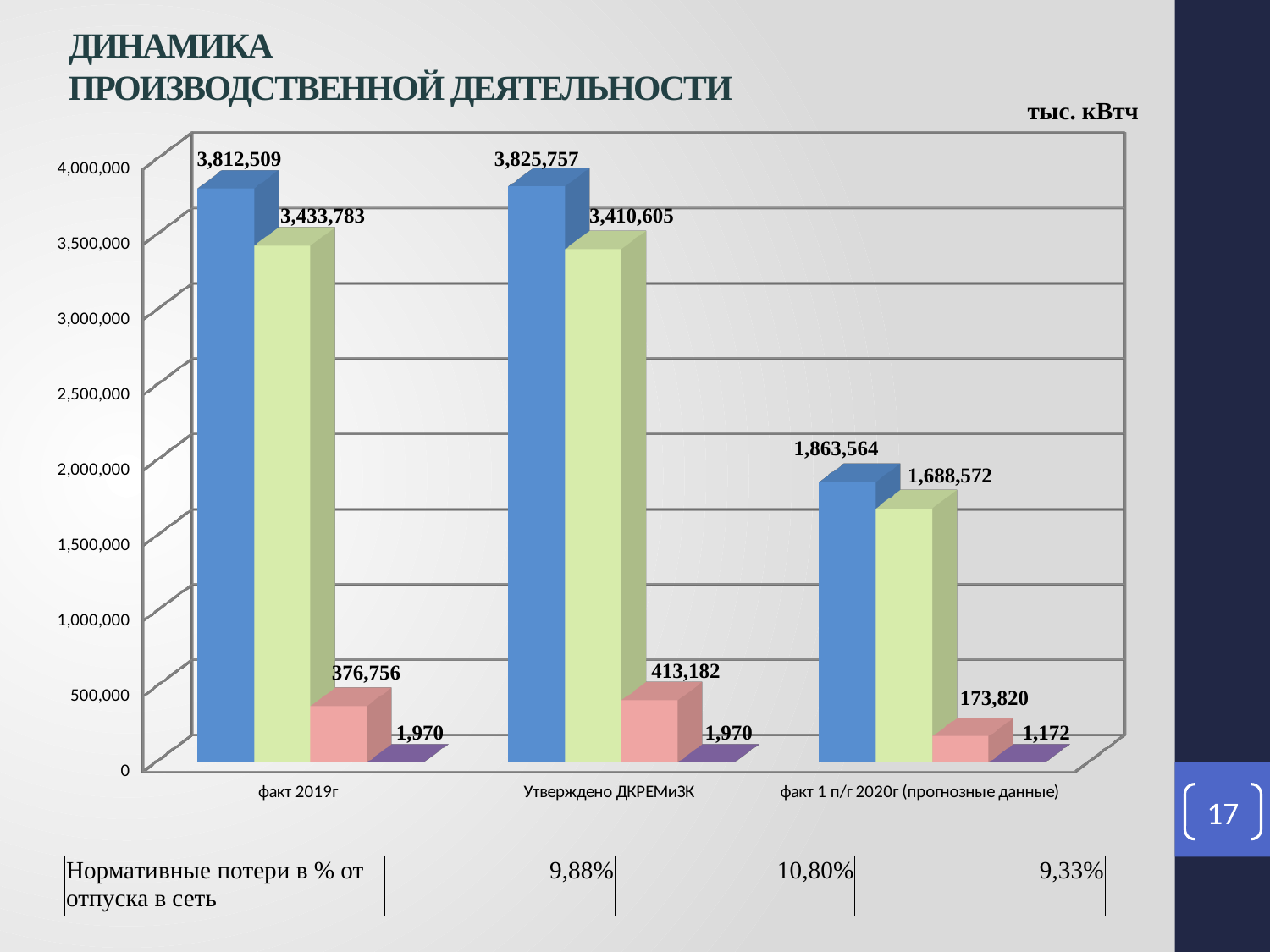
What unit is indicated above the chart? тыс. кВтч What is the value of the green bar for Утверждено ДКРЕМиЗК? 3,410,605 What is the value of the pink bar for факт 1 п/г 2020г (прогнозные данные)? 173,820 What type of chart is shown on the slide? bar chart What is the value of the purple bar for Утверждено ДКРЕМиЗК? 1,970 Which category has the highest blue bar? Утверждено ДКРЕМиЗК Which category has the lowest green bar? факт 1 п/г 2020г (прогнозные данные) Is the blue bar for факт 1 п/г 2020г (прогнозные данные) greater or less than 2,000,000? less What is the value of the blue bar for факт 2019г? 3,812,509 Which is larger: the pink bar for факт 2019г or the pink bar for Утверждено ДКРЕМиЗК? Утверждено ДКРЕМиЗК What is the difference between the blue bar and the green bar for факт 2019г? 378,726 How many categories are shown on the x axis of the chart? 3